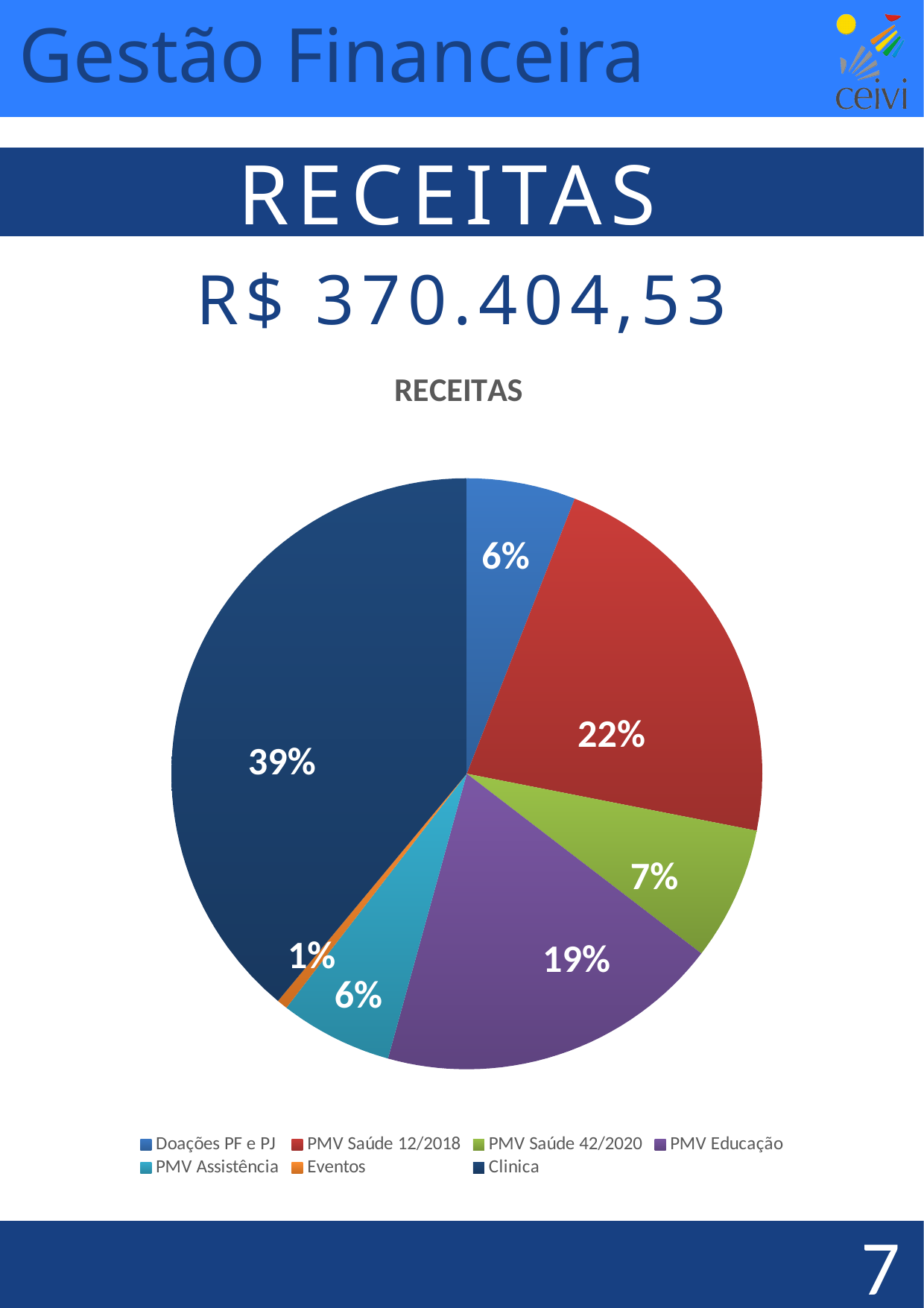
What share of the pie does Clinica represent? 39% Which category has the largest share of the pie? Clinica What kind of chart is shown on the slide? pie chart What is the title of the chart? RECEITAS What share of the pie does Eventos represent? 1% What share of the pie does PMV Saúde 12/2018 represent? 22% What is the difference in percentage points between the Clinica share and the PMV Educação share? 20 Which is larger, the share for PMV Saúde 12/2018 or the share for PMV Educação? PMV Saúde 12/2018 Which category has the smallest share of the pie? Eventos How many slices does the pie chart have? 7